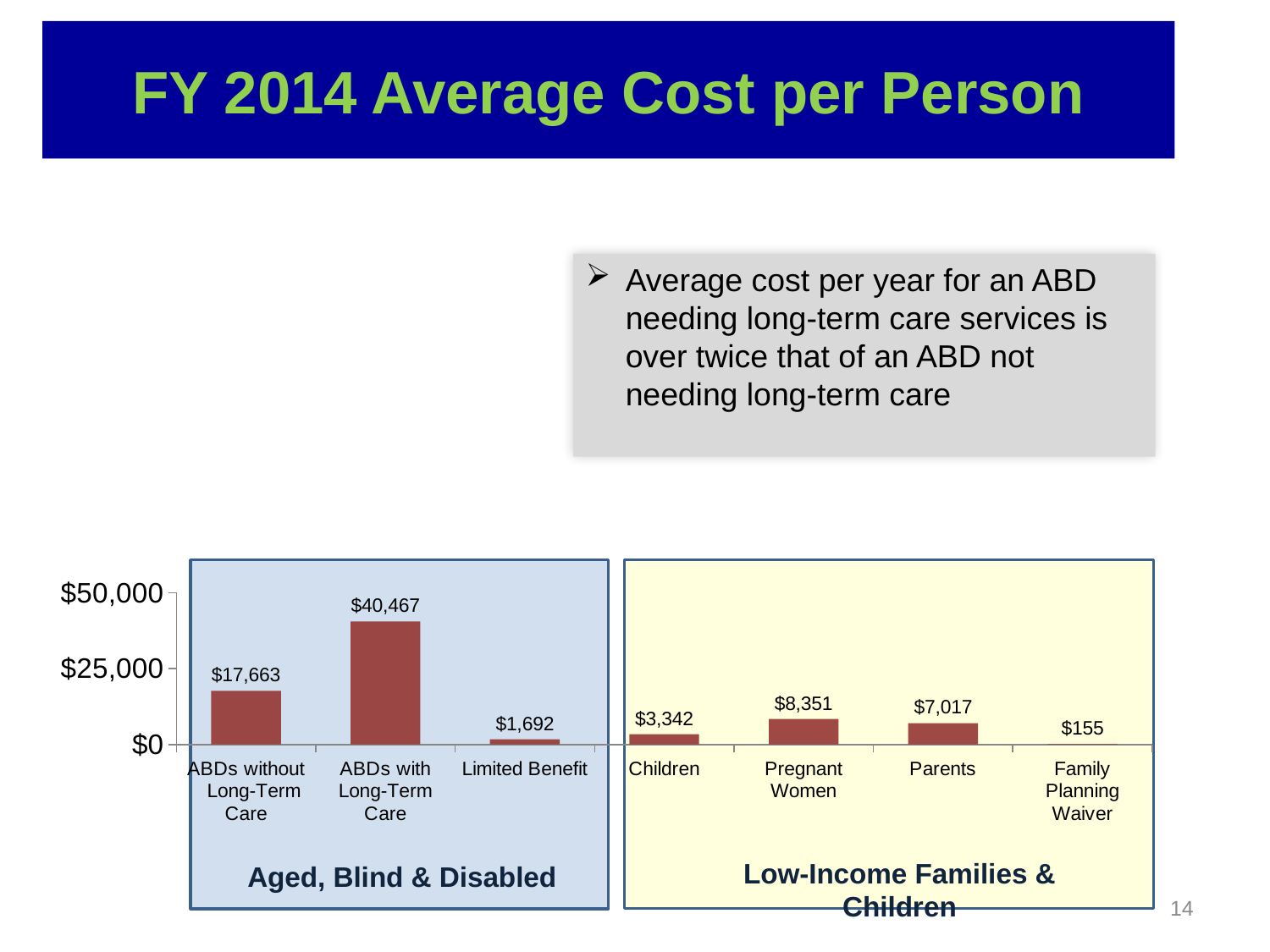
Which category has the highest average cost per person? ABDs with Long-Term Care Which category has the lowest average cost per person? Family Planning Waiver Which has a higher average cost per person, Children or Parents? Parents What is the difference in average cost per person between ABDs with Long-Term Care and ABDs without Long-Term Care? $22,804 Is the value for ABDs without Long-Term Care greater or less than $25,000? less What is the average cost per person for the Family Planning Waiver category? $155 What is the average cost per person for Pregnant Women? $8,351 What are the two group labels shown beneath the chart? Aged, Blind & Disabled; Low-Income Families & Children What is the difference in average cost per person between Pregnant Women and Parents? $1,334 What is the average cost per person for ABDs with Long-Term Care? $40,467 How many categories are shown in the chart? 7 What kind of chart is shown on the slide? Bar chart